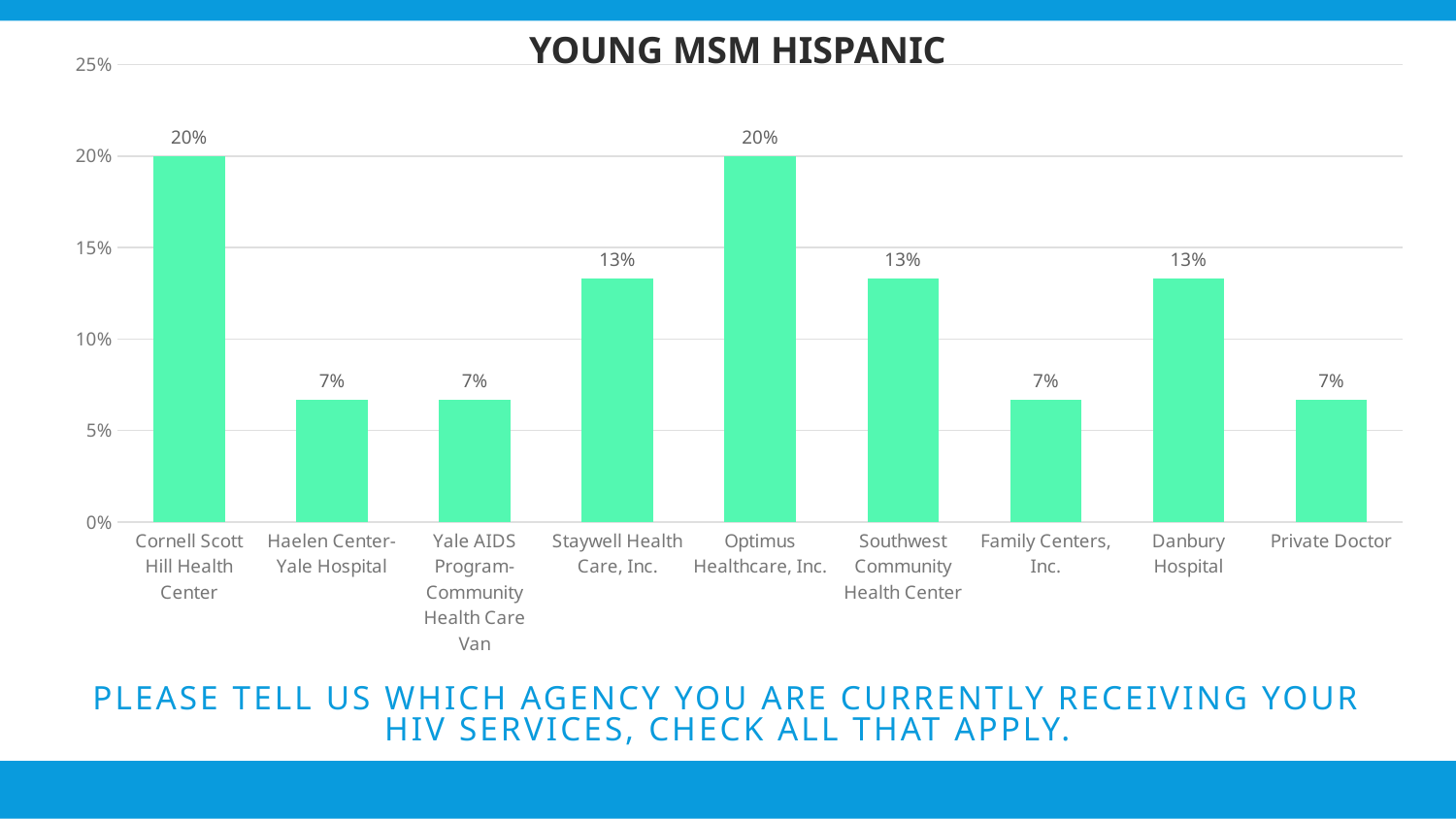
Is the value for Family Centers, Inc. greater or less than 10%? less What is the value for Private Doctor? 7% What is the value for Danbury Hospital? 13% What is the value for Staywell Health Care, Inc.? 13% What is the difference between the value for Cornell Scott Hill Health Center and the value for Yale AIDS Program-Community Health Care Van? 13% Which is larger, the value for Haelen Center-Yale Hospital or the value for Danbury Hospital? Danbury Hospital What kind of chart is shown on the slide? bar chart Which agencies have the highest value on the chart? Cornell Scott Hill Health Center and Optimus Healthcare, Inc. What is the difference between the value for Optimus Healthcare, Inc. and the value for Southwest Community Health Center? 7% How many agencies are shown on the chart? 9 What is the title of the chart? YOUNG MSM HISPANIC What is the value for Cornell Scott Hill Health Center? 20%